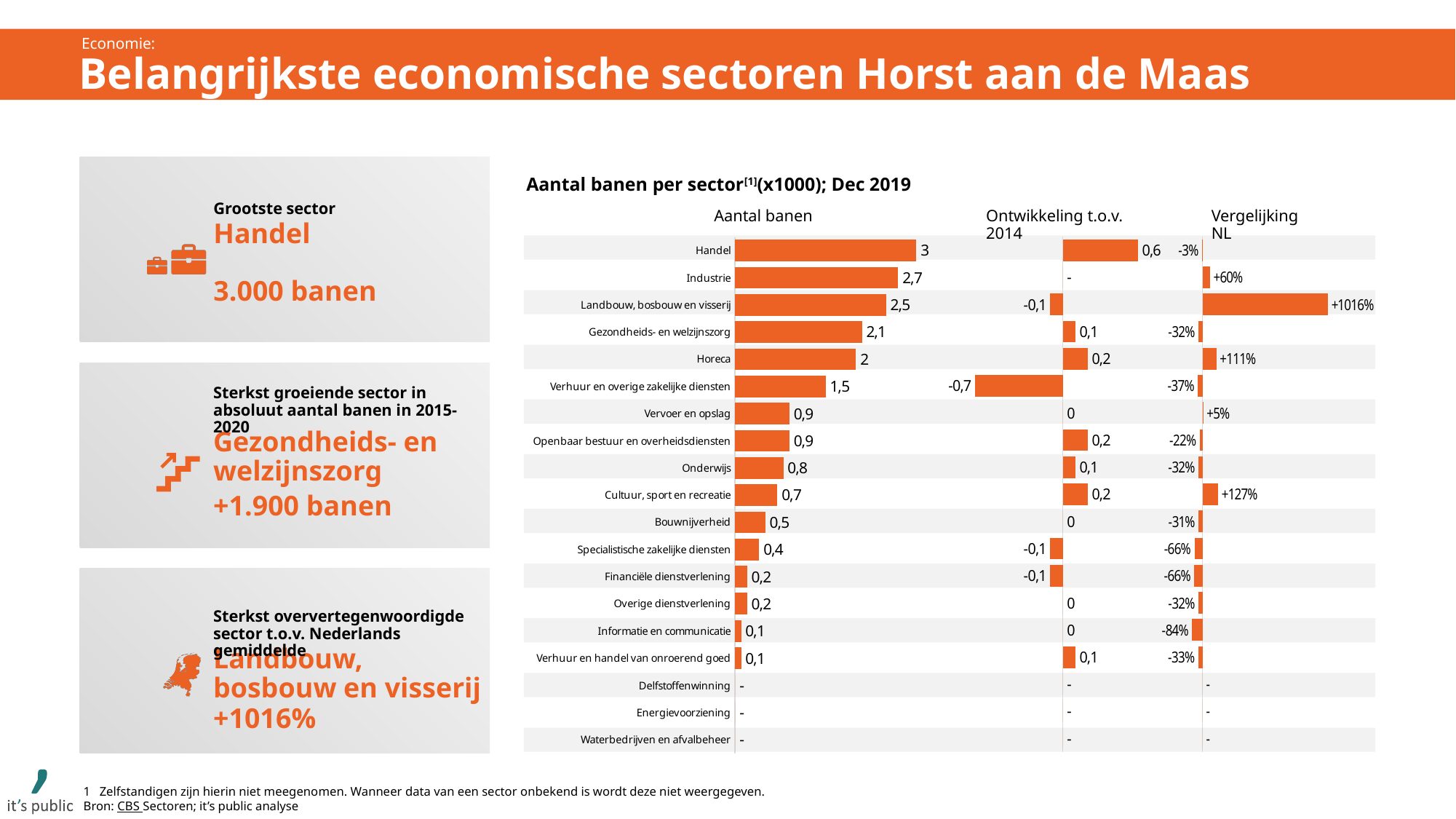
In the 'Aantal banen' column, which is larger: Gezondheids- en welzijnszorg or Onderwijs? Gezondheids- en welzijnszorg How many sectors are listed in the chart? 19 In the 'Ontwikkeling t.o.v. 2014' column, what is the value for Verhuur en overige zakelijke diensten? -0,7 What is the title of the chart? Aantal banen per sector (x1000); Dec 2019 In the 'Vergelijking NL' column, which is larger: Horeca or Industrie? Horeca In the 'Aantal banen' column, what is the value for Industrie? 2,7 Which sector has the highest value in the 'Aantal banen' column? Handel What is the difference between the 'Aantal banen' values for Handel and Horeca? 1 What kind of chart is used to show the values in the 'Aantal banen' column? Bar chart Which sector has the lowest value in the 'Ontwikkeling t.o.v. 2014' column? Verhuur en overige zakelijke diensten Which sector has the highest value in the 'Vergelijking NL' column? Landbouw, bosbouw en visserij In the 'Vergelijking NL' column, what is the value for Cultuur, sport en recreatie? +127%